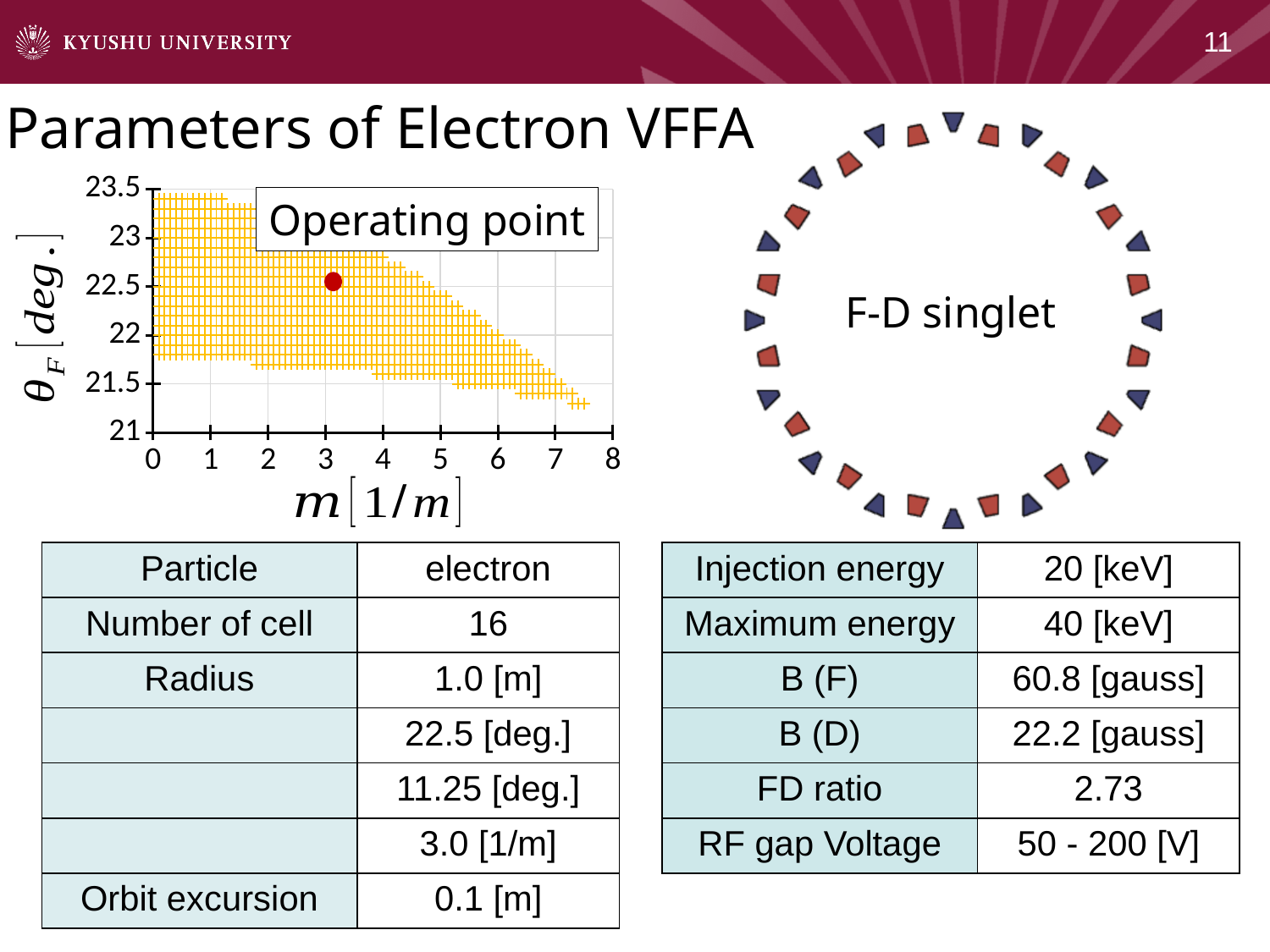
In the left chart, is the m value of the operating point greater or less than 2? greater In the left chart, is the θ_F value of the operating point greater or less than 22? greater In the left chart, what is the label of the y axis? θ_F [deg.] In the left chart, is the m value of the operating point greater or less than 4? less In the left chart, what is the label of the x axis? m [1/m] In the left chart, what is the highest value shown on the x axis? 8 In the left chart, what is the highest value shown on the y axis? 23.5 In the left chart, what is the lowest value shown on the y axis? 21 What kind of chart is shown on the left of the slide, under the title 'Parameters of Electron VFFA'? scatter plot In the left chart, does the upper edge of the yellow shaded region rise or fall as m increases from 3 to 7? fall In the left chart, how many tick labels are shown on the x axis? 9